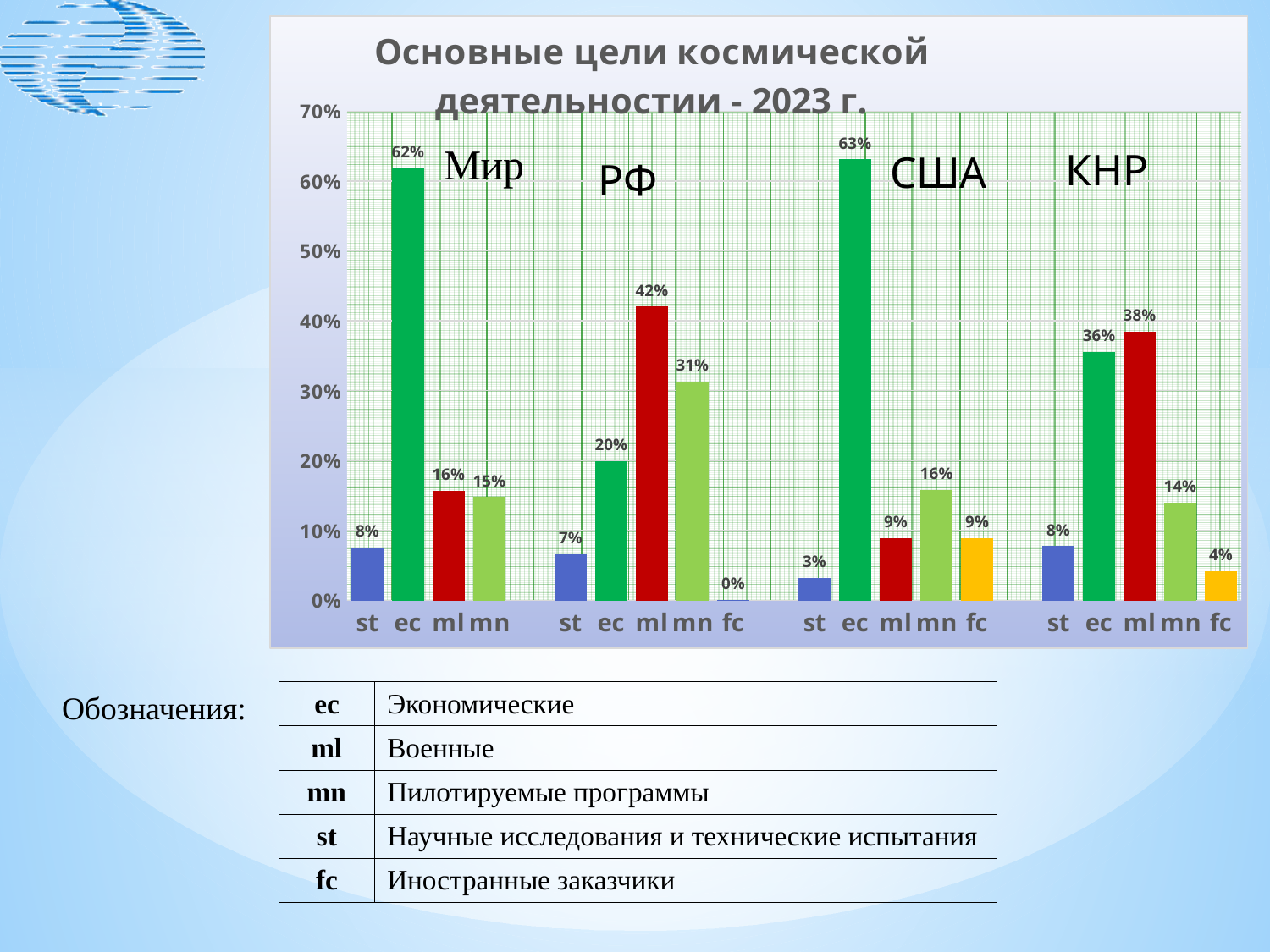
Which is larger: mn in the РФ group or mn in the США group? mn in the РФ group What is the value for fc in the США group? 9% What is the value for ml in the РФ group? 42% Which category has the lowest value in the РФ group? fc Which category has the highest value in the США group? ec What is the difference between ec in the США group and ec in the РФ group? 43% What is the difference between ml and ec in the КНР group? 2% How many country groups are shown on the chart? 4 What is the value for ec in the Мир group? 62% What kind of chart is shown on the slide? bar chart What is the value for mn in the КНР group? 14% What is the title of the chart? Основные цели космической деятельностии - 2023 г.